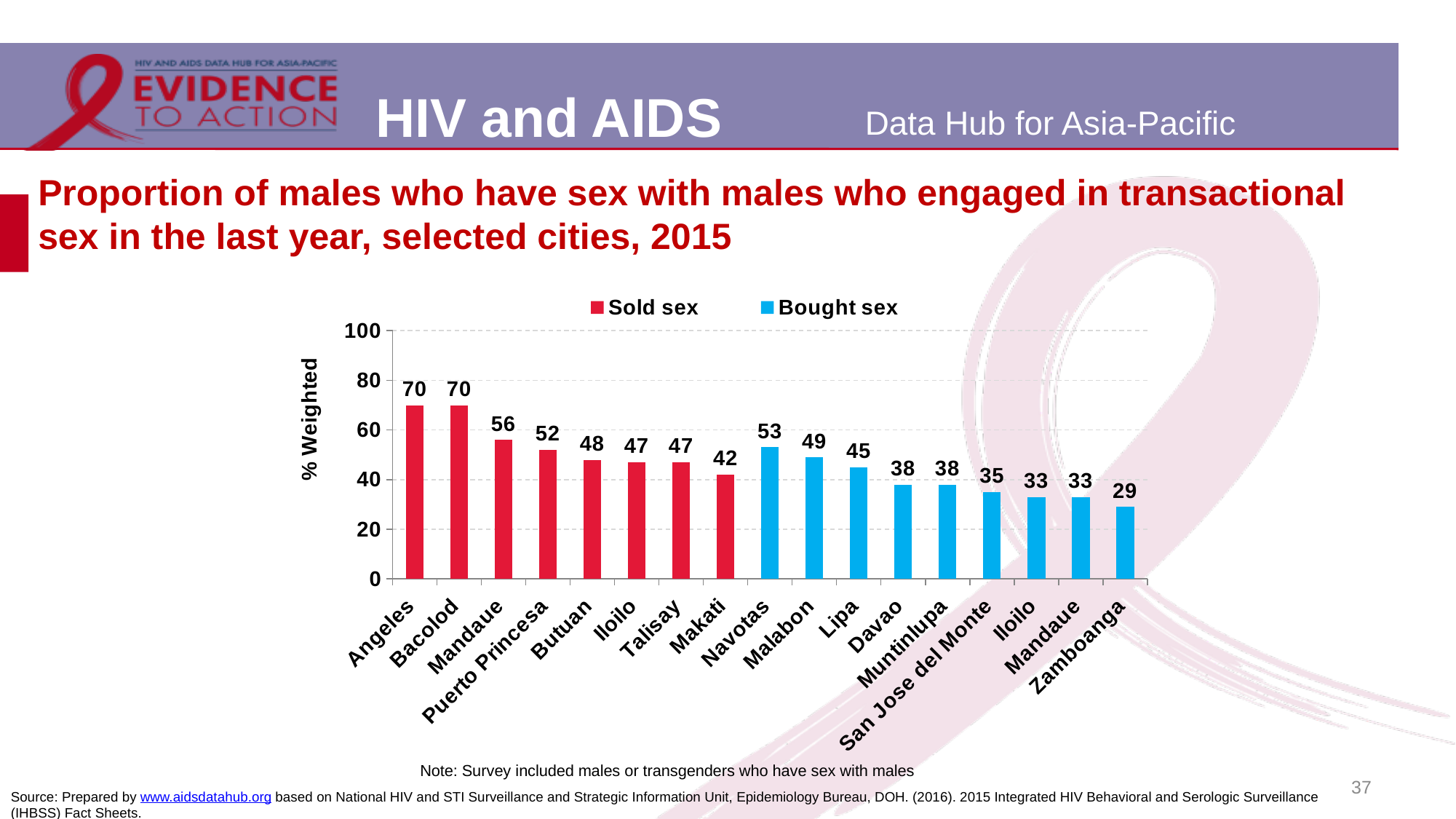
What is the Sold sex value for Makati? 42 What is the Sold sex value for Puerto Princesa? 52 What is the Bought sex value for Zamboanga? 29 What is the label of the y axis? % Weighted What is the Bought sex value for Navotas? 53 What is the difference between the Sold sex value for Angeles and the Sold sex value for Mandaue? 14 What kind of chart is shown on the slide? Bar chart Which is larger: the Bought sex value for Malabon or the Bought sex value for Lipa? Malabon How many bars are plotted in the chart? 17 How many series does the legend list? 2 Which city has the highest value in the Bought sex series? Navotas Which city has the lowest value in the Bought sex series? Zamboanga